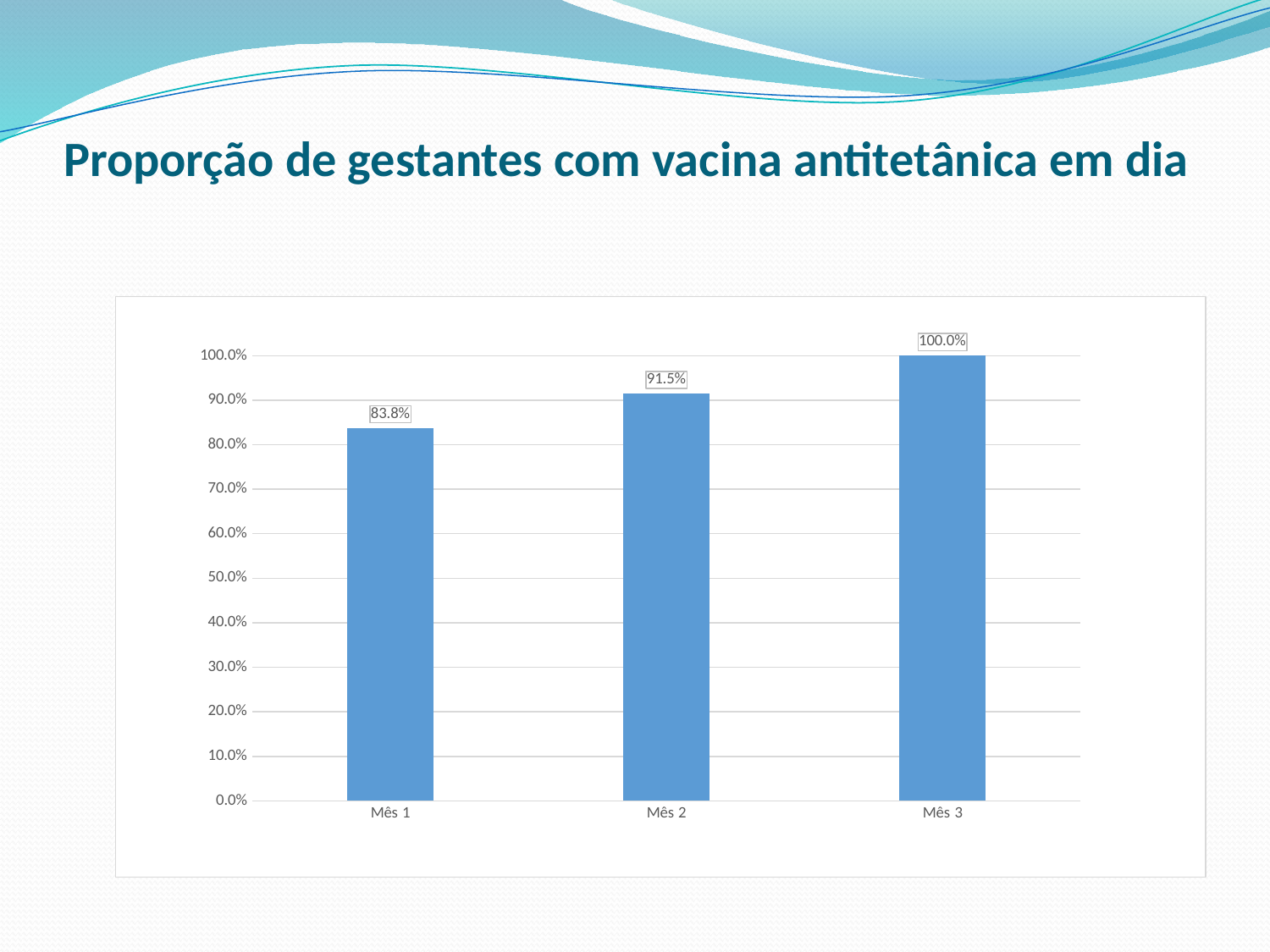
What is the value for Mês 1? 83.8% What is the difference between the values for Mês 2 and Mês 1? 7.7% How many months are shown on the x axis? 3 Which is larger, the value for Mês 1 or the value for Mês 2? Mês 2 What is the difference between the values for Mês 3 and Mês 1? 16.2% Which month has the lowest value? Mês 1 Is the value for Mês 1 greater or less than 90.0%? less Do the values rise or fall from Mês 1 to Mês 3? rise What is the value for Mês 3? 100.0% Which month has the highest value? Mês 3 What kind of chart is shown on the slide? bar chart What is the value for Mês 2? 91.5%